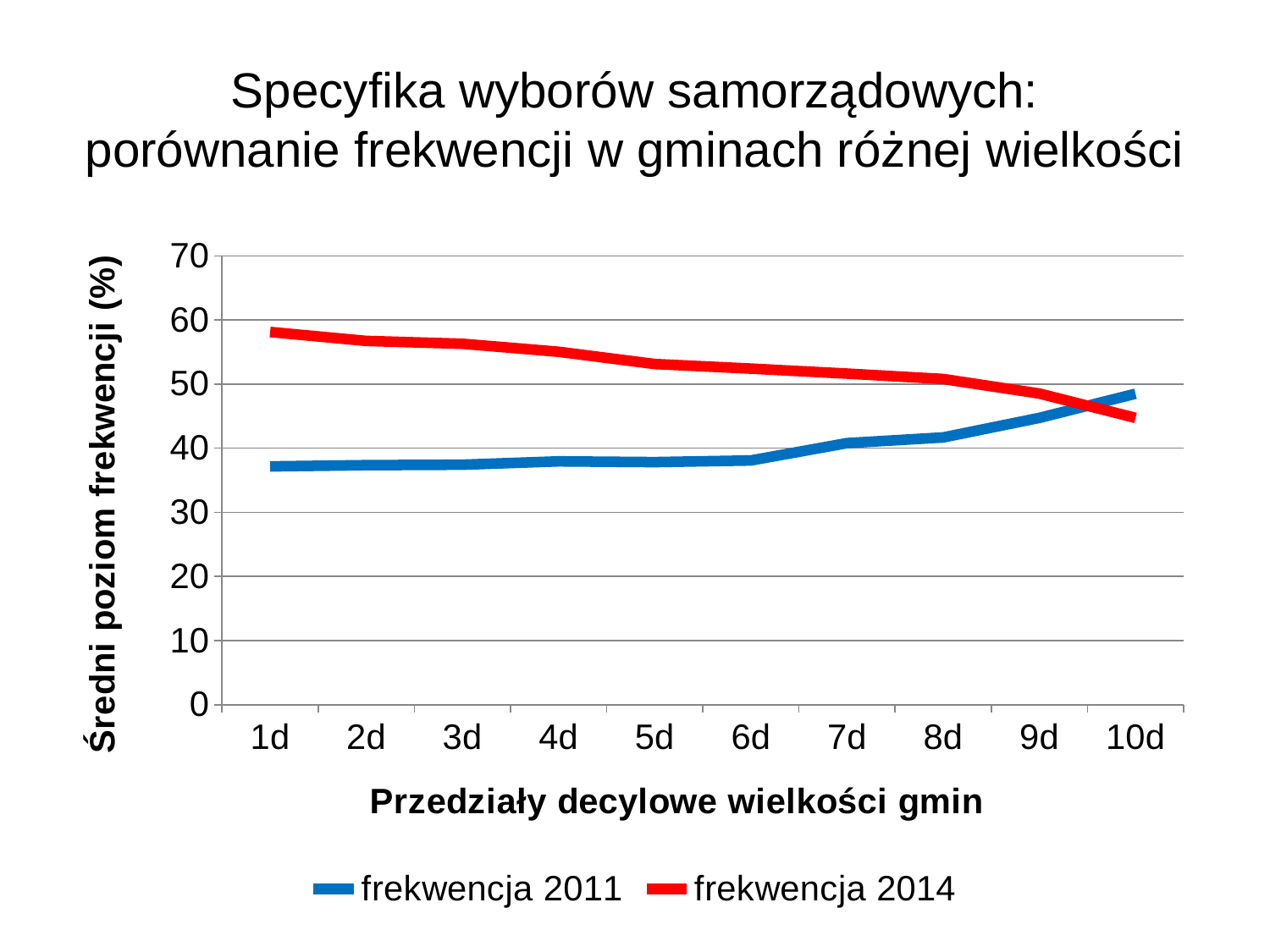
How many decile categories are shown on the x axis? 10 For which decile is frekwencja 2011 highest? 10d At 1d, which series has the higher value, frekwencja 2011 or frekwencja 2014? frekwencja 2014 Does the frekwencja 2011 line rise or fall from 1d to 10d? rises What kind of chart is shown on the slide? line chart At 10d, which series has the higher value, frekwencja 2011 or frekwencja 2014? frekwencja 2011 How many series does the legend list? 2 Is the value for frekwencja 2014 at 1d greater or less than 50? greater Is the value for frekwencja 2011 at 1d greater or less than 40? less Is the value for frekwencja 2011 at 10d greater or less than 40? greater Does the frekwencja 2014 line rise or fall from 1d to 10d? falls For which decile is frekwencja 2014 highest? 1d